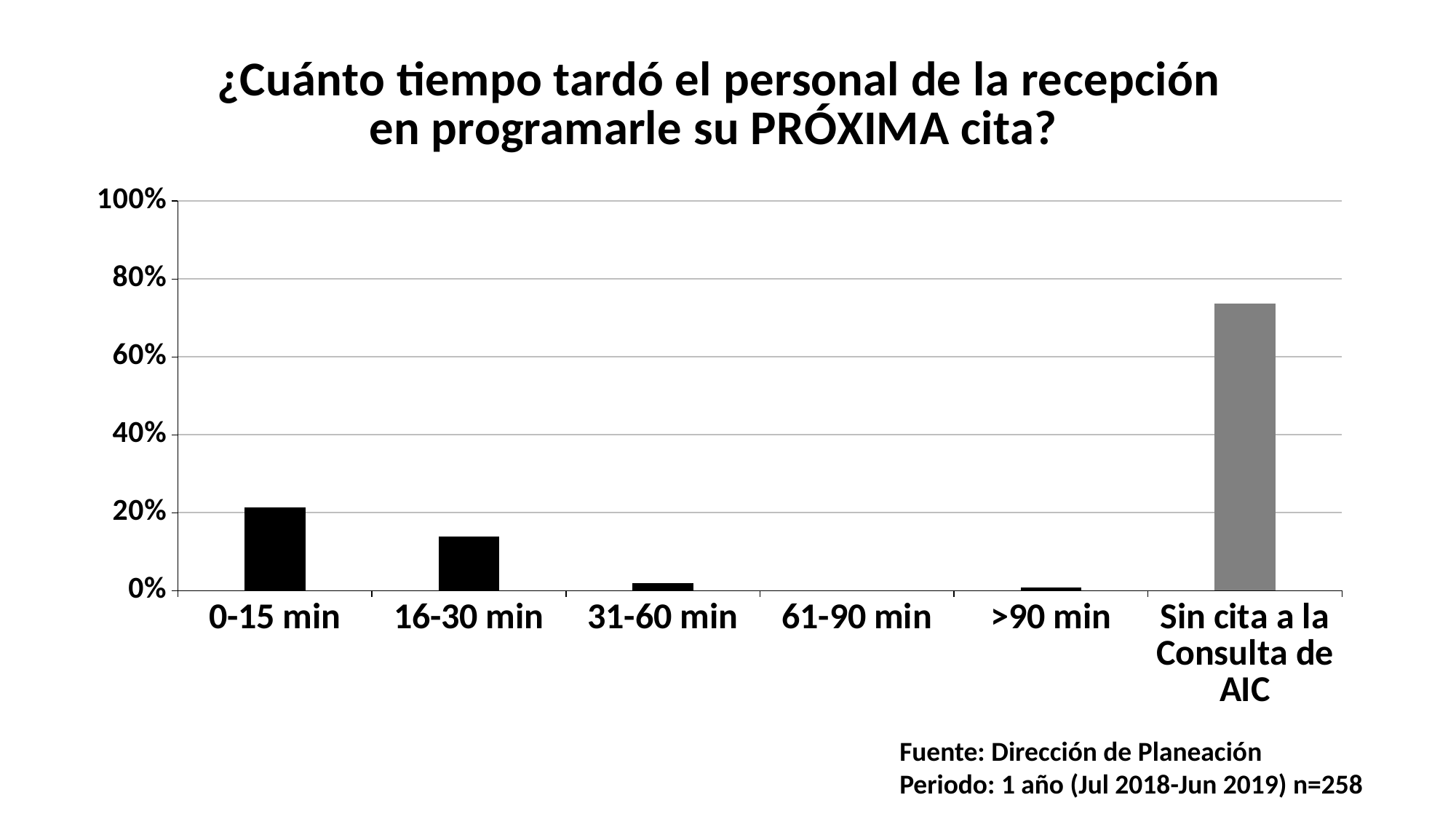
Which is larger, the value for '0-15 min' or the value for '16-30 min'? 0-15 min What is the sample size (n) stated on the slide? n=258 Which category has the highest value in the chart? Sin cita a la Consulta de AIC Is the value for '31-60 min' greater or less than 20%? less Which is larger, the value for '16-30 min' or the value for '31-60 min'? 16-30 min Which is larger, the value for 'Sin cita a la Consulta de AIC' or the value for '0-15 min'? Sin cita a la Consulta de AIC How many categories are shown on the x axis of the chart? 6 Is the value for '16-30 min' greater or less than 20%? less What is the title of the chart? ¿Cuánto tiempo tardó el personal de la recepción en programarle su PRÓXIMA cita? Is the value for 'Sin cita a la Consulta de AIC' greater or less than 60%? greater What kind of chart is shown on the slide? bar chart